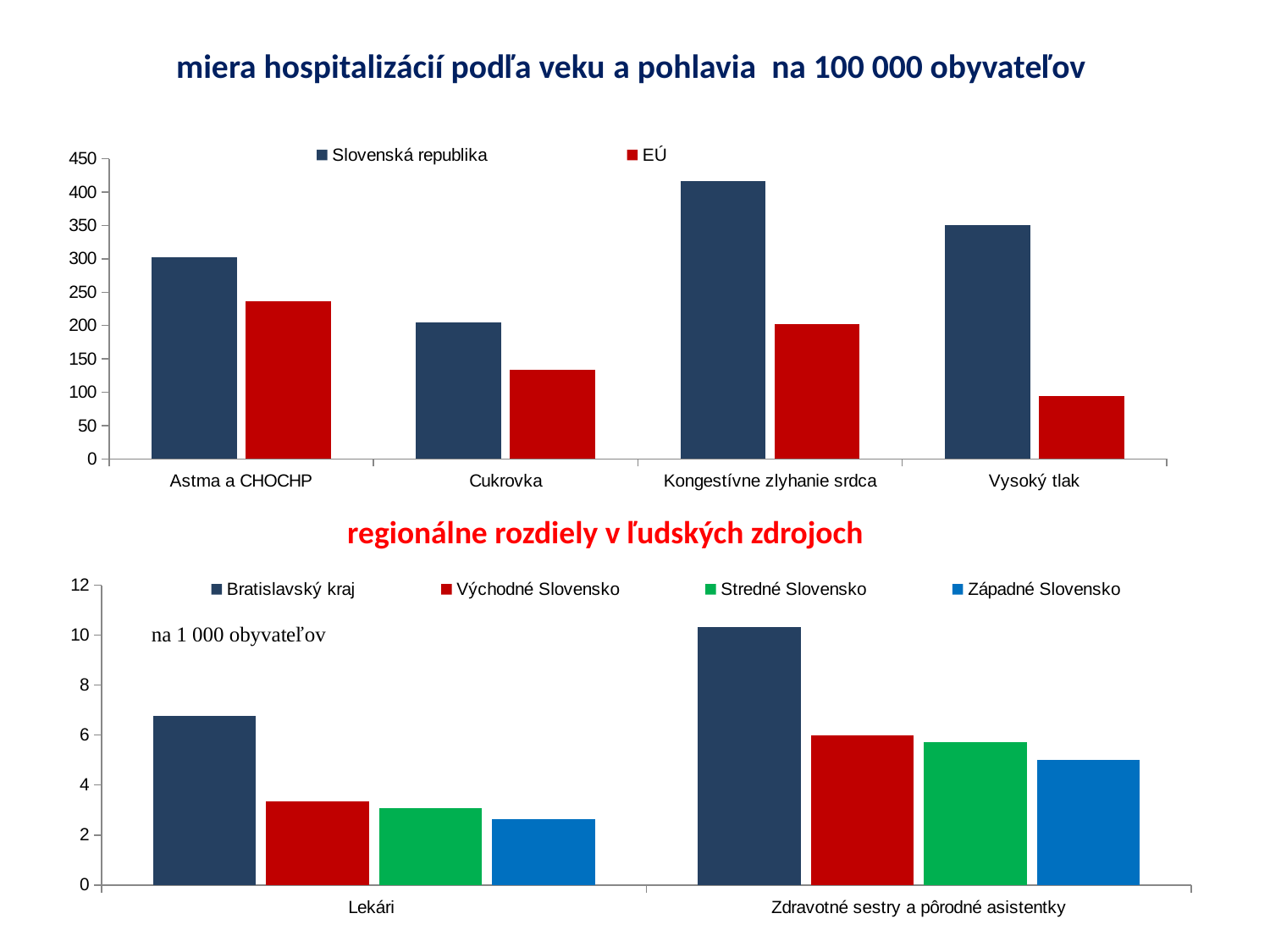
In the top chart (miera hospitalizácií), which category has the lowest value for EÚ? Vysoký tlak In the top chart (miera hospitalizácií), which is larger for Cukrovka: Slovenská republika or EÚ? Slovenská republika In the bottom chart (regionálne rozdiely v ľudských zdrojoch), which region has the lowest value for Lekári? Západné Slovensko In the top chart (miera hospitalizácií), is the EÚ value for Vysoký tlak greater or less than 100? less In the bottom chart (regionálne rozdiely v ľudských zdrojoch), is the Bratislavský kraj value for Zdravotné sestry a pôrodné asistentky greater or less than 10? greater How many series does the legend of the bottom chart (regionálne rozdiely v ľudských zdrojoch) list? 4 In the top chart (miera hospitalizácií), which category has the highest value for Slovenská republika? Kongestívne zlyhanie srdca In the bottom chart (regionálne rozdiely v ľudských zdrojoch), which region has the highest value for Zdravotné sestry a pôrodné asistentky? Bratislavský kraj How many series does the legend of the top chart (miera hospitalizácií) list? 2 What kind of chart is the bottom chart (regionálne rozdiely v ľudských zdrojoch)? bar chart In the top chart (miera hospitalizácií), is the Slovenská republika value for Kongestívne zlyhanie srdca greater or less than 400? greater How many categories are shown on the x axis of the top chart (miera hospitalizácií)? 4